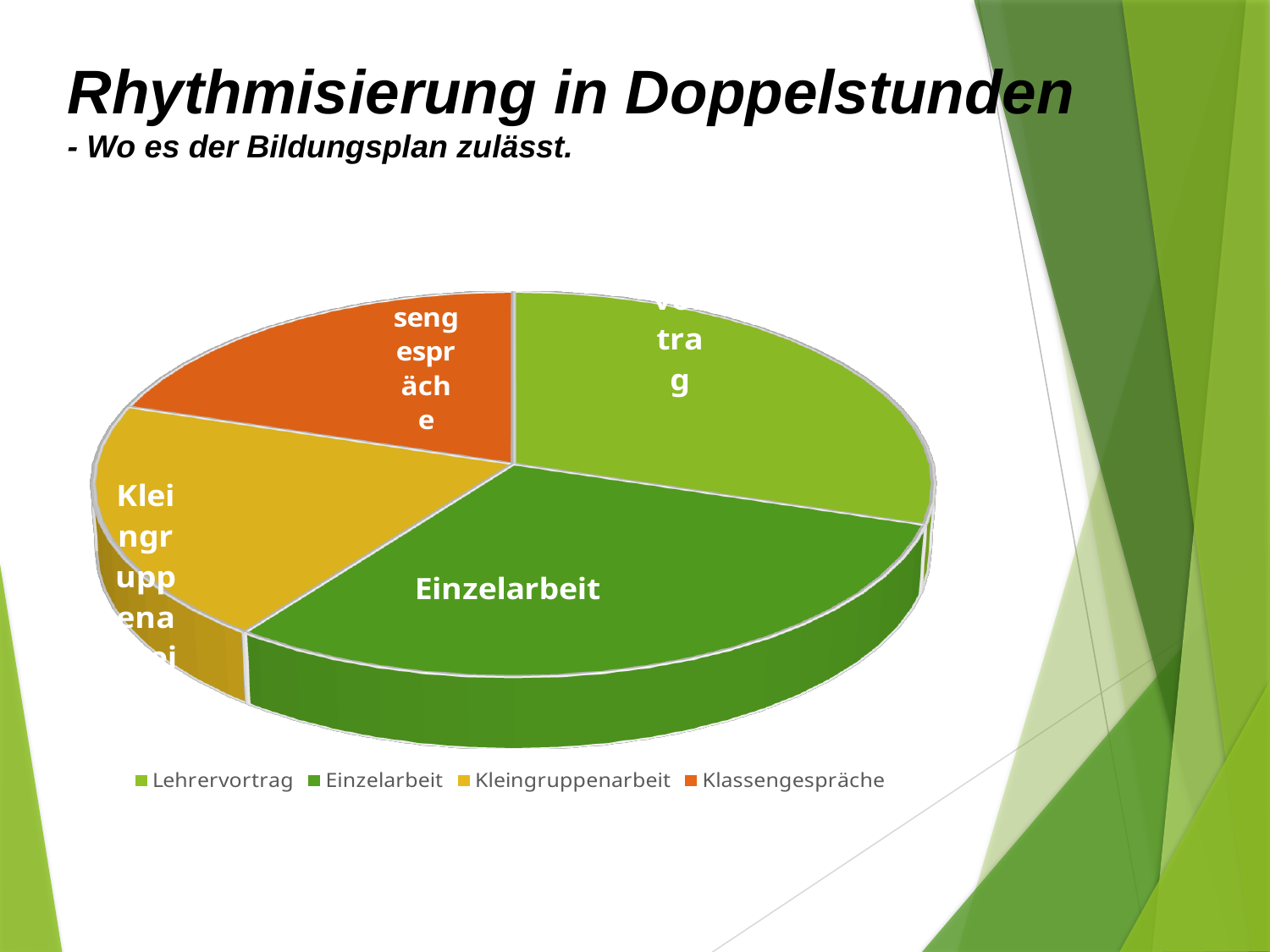
How many slices does the pie chart have? 4 What is the title of the slide containing the pie chart? Rhythmisierung in Doppelstunden Which slice is larger, Einzelarbeit or Kleingruppenarbeit? Einzelarbeit What colour is the Klassengespräche slice in the pie chart? orange What kind of chart is shown on the slide? pie chart How many entries does the legend of the pie chart list? 4 Which slice is larger, Lehrervortrag or Klassengespräche? Lehrervortrag